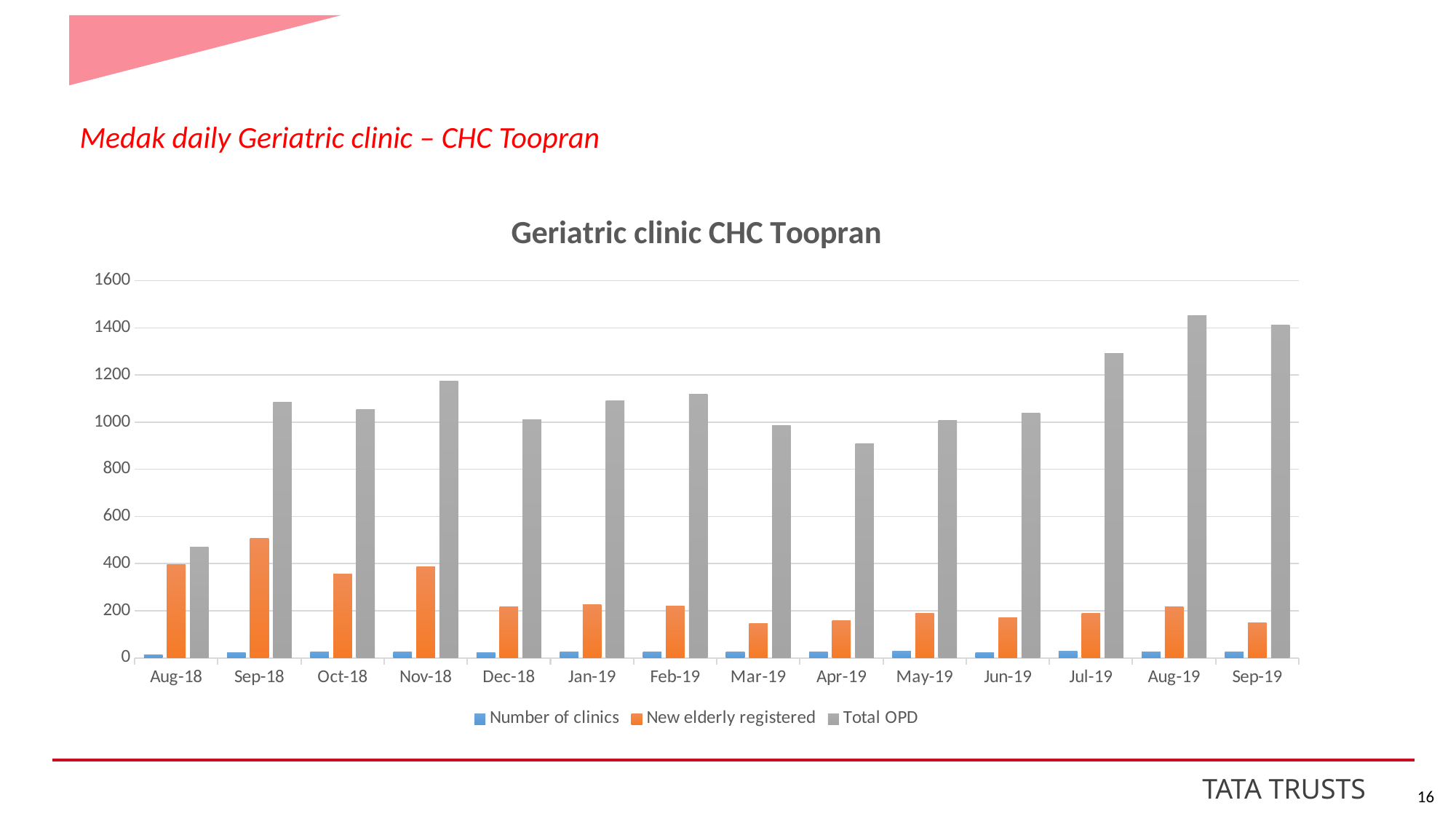
Is the Total OPD for Apr-19 greater or less than 1000? less Does the Total OPD rise or fall from Jun-19 to Aug-19? rise Which month has the larger Total OPD, Nov-18 or Dec-18? Nov-18 Is the number of New elderly registered in Sep-18 greater or less than 400? greater How many months are shown on the x axis? 14 How many series does the legend list? 3 Which month has the highest Total OPD? Aug-19 Is the Total OPD for Aug-18 greater or less than 600? less Which month has the lowest Total OPD? Aug-18 What kind of chart is shown on the slide? bar chart Which month has the highest number of New elderly registered? Sep-18